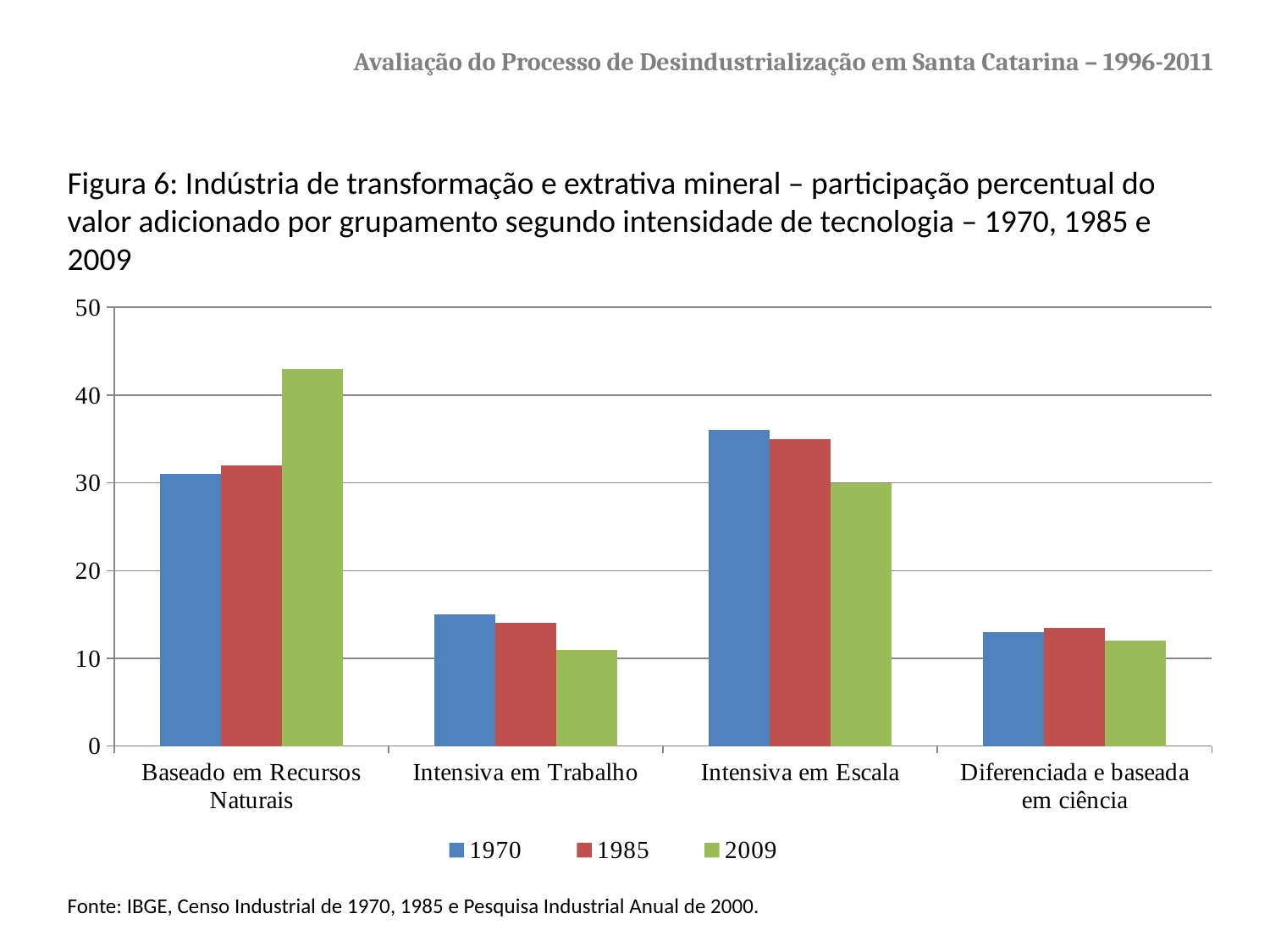
Which category has the highest value for 2009? Baseado em Recursos Naturais Is the 2009 value for Baseado em Recursos Naturais greater or less than 40? greater For Intensiva em Escala, which year has the lowest value? 2009 How many categories are shown on the x axis? 4 How many series does the legend list? 3 Is the 1970 value for Intensiva em Escala greater or less than 30? greater Do the values for Baseado em Recursos Naturais rise or fall from 1970 to 2009? rise What kind of chart is shown on the slide? Bar chart Which years are listed in the legend? 1970, 1985, 2009 Do the values for Intensiva em Escala rise or fall from 1970 to 2009? fall Is the 1970 value for Intensiva em Trabalho greater or less than 20? less Which is larger for 1970: Intensiva em Escala or Baseado em Recursos Naturais? Intensiva em Escala